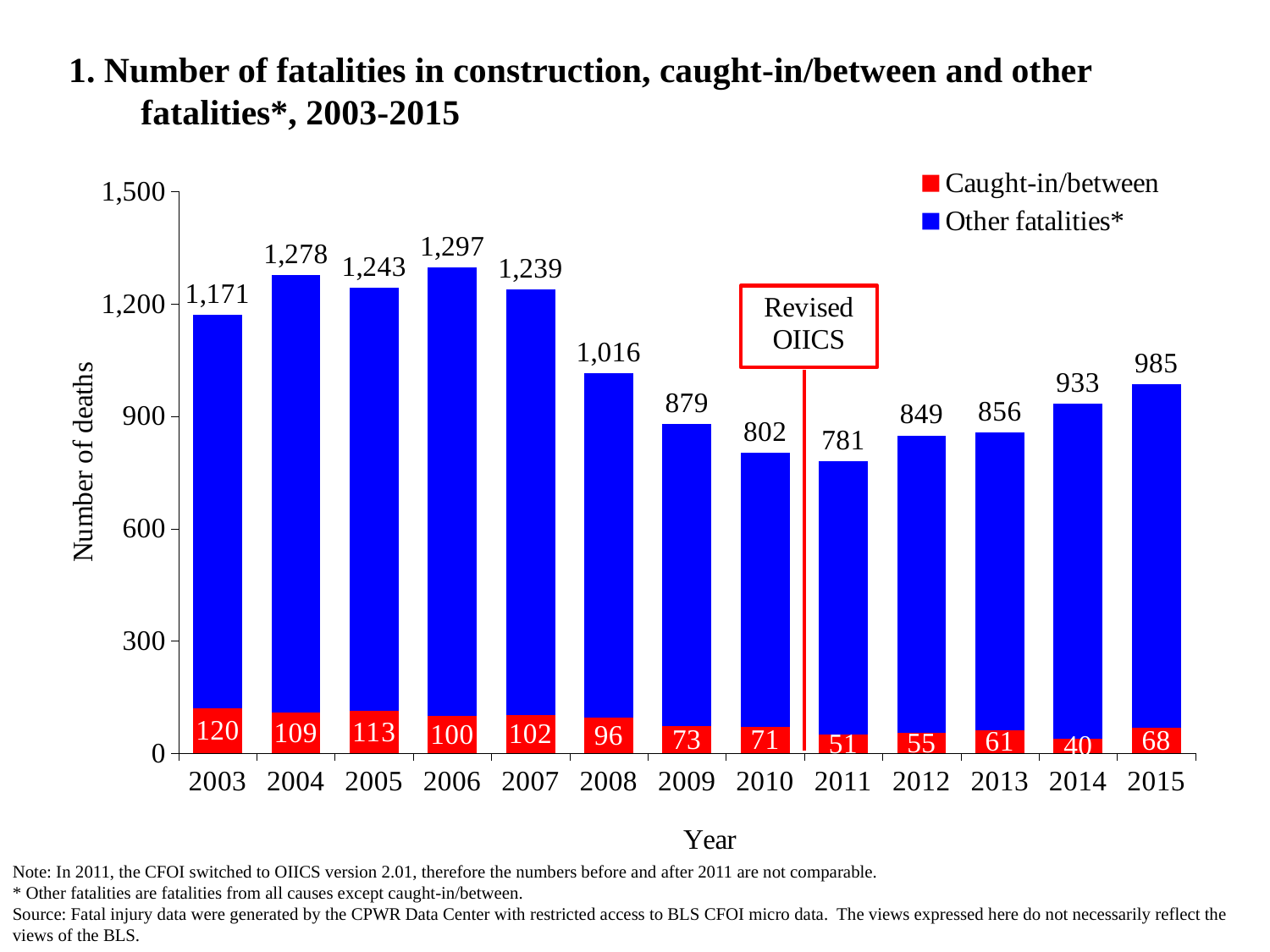
What is the difference between the caught-in/between fatalities in 2003 and 2014? 80 Which year has the lowest number of caught-in/between fatalities? 2014 How many years are shown on the x axis? 13 Which year has the highest total number of deaths? 2006 Which year has more caught-in/between fatalities, 2012 or 2013? 2013 What type of chart is shown on the slide? Stacked bar chart What is the total number of deaths shown for 2006? 1,297 What is the number of caught-in/between fatalities in 2008? 96 Do the total deaths rise or fall from 2011 to 2015? rise What colour represents caught-in/between fatalities in the chart? Red Is the total number of deaths in 2010 greater or less than 900? less How many series does the legend list? 2